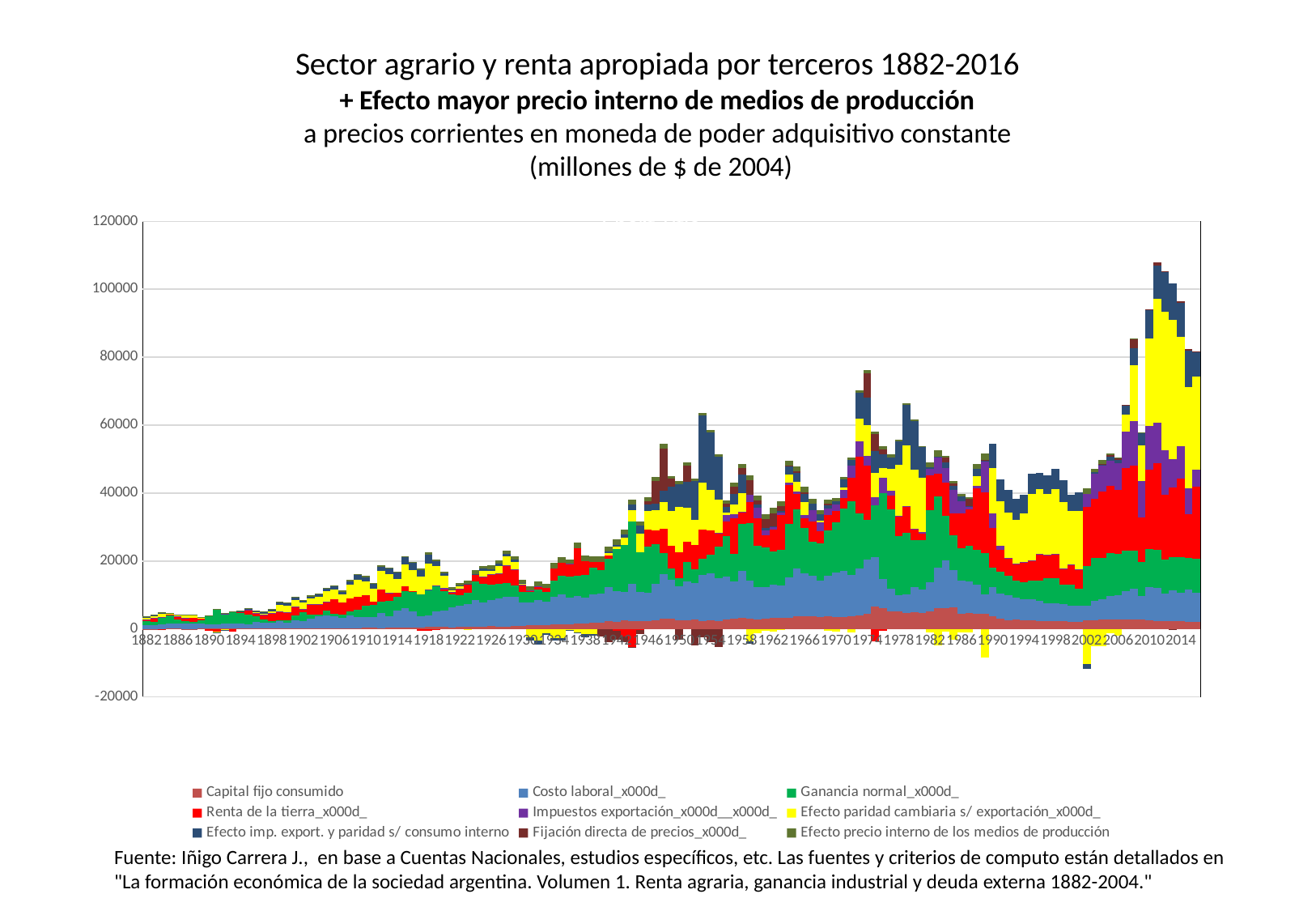
Does the tallest stacked bar occur before or after the year 2000? after What is the lowest value shown on the vertical axis? -20000 Is the total stacked value for 1930 greater or less than 40000? less How many series does the legend list? 9 Is the total stacked value for 1882 greater or less than 20000? less What kind of chart is shown on the slide? Stacked bar chart Is the peak stacked value around 1974 greater or less than 60000? greater What is the highest value shown on the vertical axis? 120000 Which is larger, the total stacked value for 1882 or for 2014? 2014 Overall, do the stacked totals rise or fall from 1882 to 2016? rise